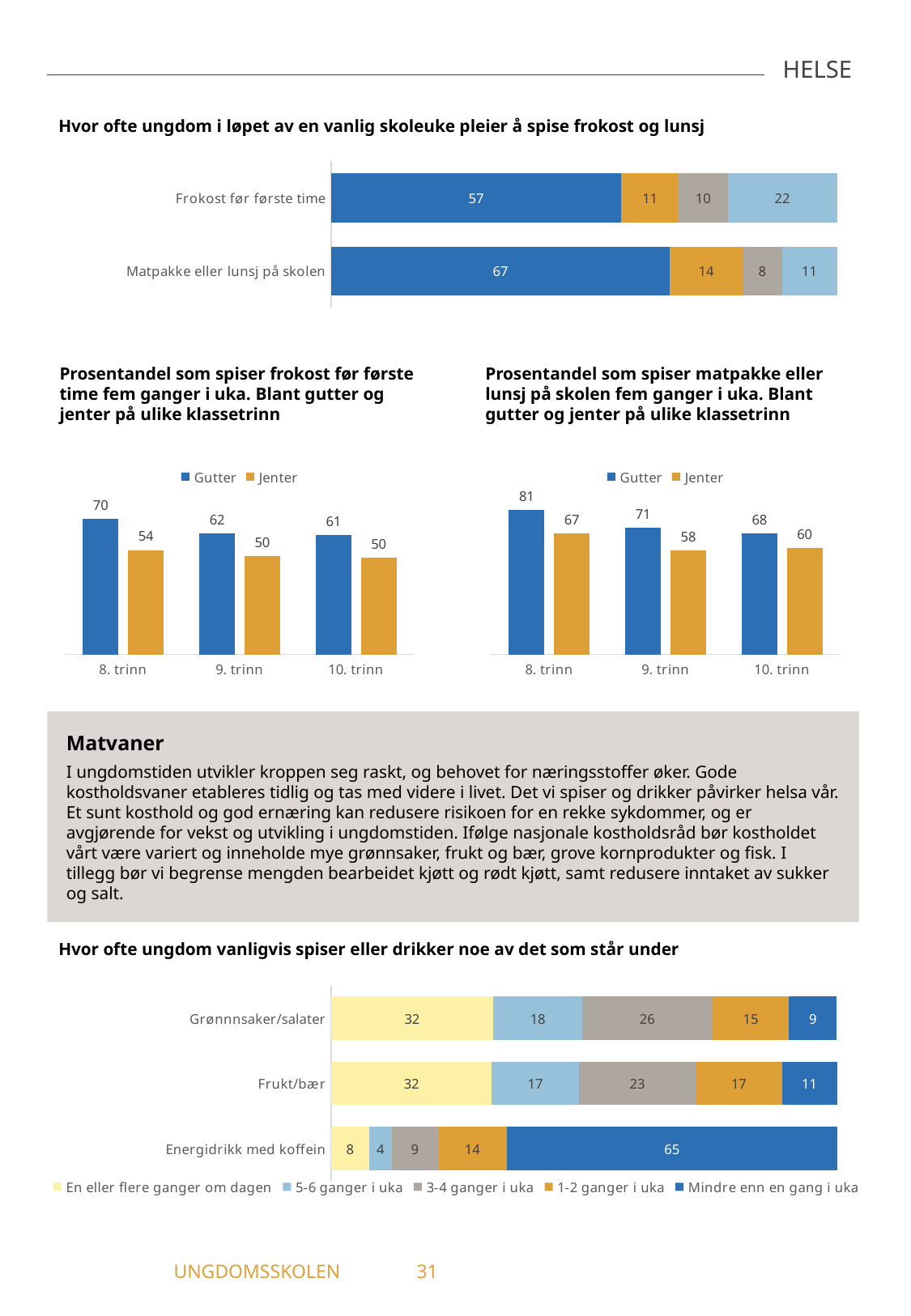
In the chart 'Hvor ofte ungdom vanligvis spiser eller drikker noe av det som står under', what is the value for 'Mindre enn en gang i uka' for 'Energidrikk med koffein'? 65 In the chart 'Prosentandel som spiser matpakke eller lunsj på skolen fem ganger i uka', how many series does the legend list? 2 In the chart 'Hvor ofte ungdom vanligvis spiser eller drikker noe av det som står under', which is larger: the '3-4 ganger i uka' value for 'Grønnnsaker/salater' or for 'Frukt/bær'? Grønnnsaker/salater In the chart 'Hvor ofte ungdom i løpet av en vanlig skoleuke pleier å spise frokost og lunsj', what kind of chart is shown? Stacked bar chart In the chart 'Prosentandel som spiser frokost før første time fem ganger i uka', what is the value for Gutter in 8. trinn? 70 In the chart 'Prosentandel som spiser matpakke eller lunsj på skolen fem ganger i uka', which class level has the highest value for Gutter? 8. trinn In the chart 'Hvor ofte ungdom i løpet av en vanlig skoleuke pleier å spise frokost og lunsj', what is the value of the largest (first) segment for 'Matpakke eller lunsj på skolen'? 67 In the chart 'Hvor ofte ungdom vanligvis spiser eller drikker noe av det som står under', how many categories are shown? 3 In the chart 'Prosentandel som spiser matpakke eller lunsj på skolen fem ganger i uka', what is the value for Jenter in 10. trinn? 60 In the chart 'Prosentandel som spiser frokost før første time fem ganger i uka', what is the difference between Gutter and Jenter in 9. trinn? 12 In the chart 'Hvor ofte ungdom i løpet av en vanlig skoleuke pleier å spise frokost og lunsj', what is the total of the stacked bar for 'Frokost før første time'? 100 In the chart 'Prosentandel som spiser frokost før første time fem ganger i uka', do the Gutter values rise or fall from 8. trinn to 10. trinn? Fall